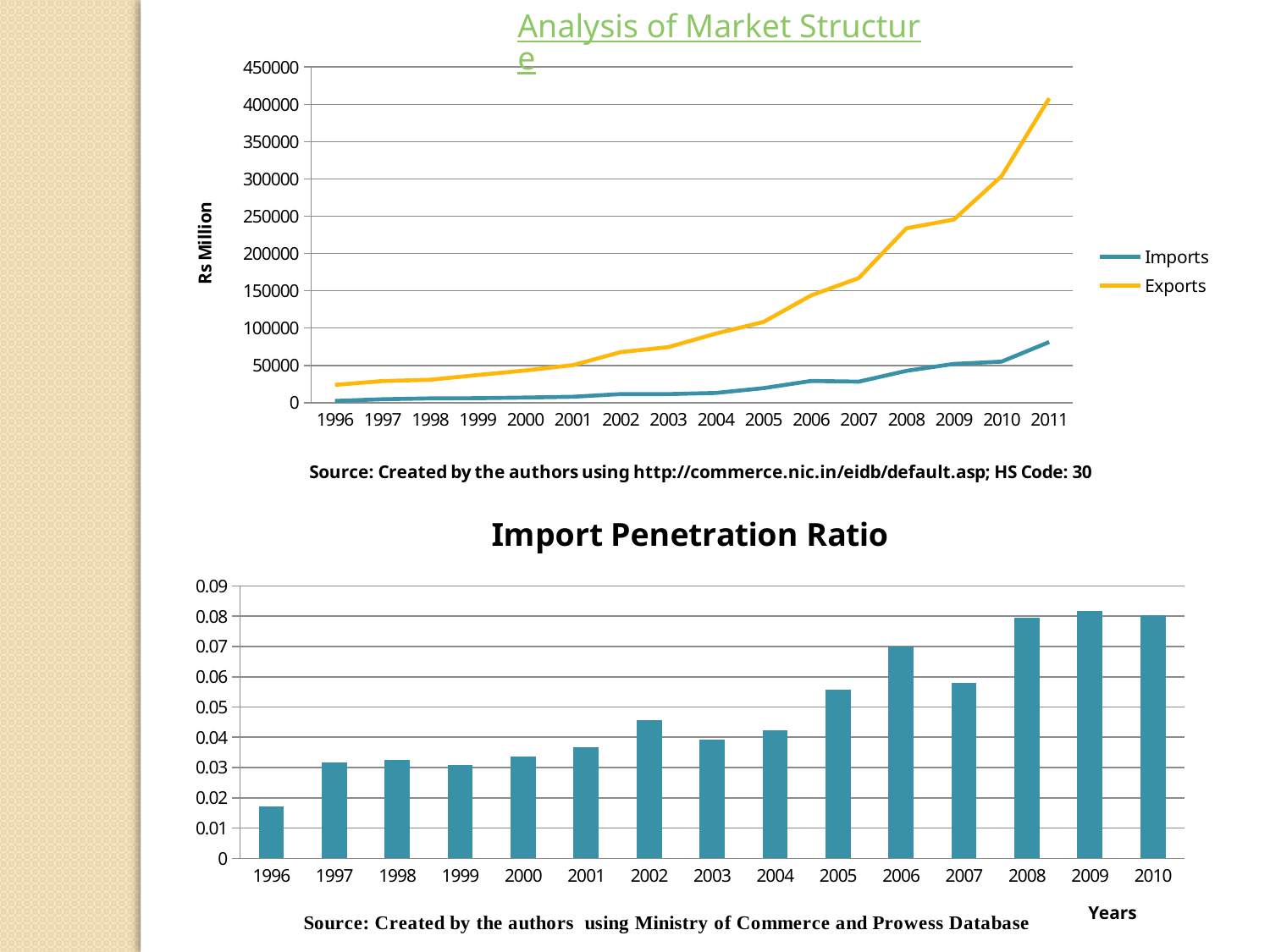
In the top chart, is the value for Exports in 2008 greater or less than 200000? greater In the 'Import Penetration Ratio' chart, is the value for 2005 greater or less than 0.05? greater In the top chart, is the value for Exports in 2011 greater or less than 350000? greater How many years are shown on the x axis of the 'Import Penetration Ratio' chart? 15 In the top chart, do Exports generally rise or fall from 1996 to 2011? rise What type of chart is the 'Import Penetration Ratio' chart? bar chart In the 'Import Penetration Ratio' chart, which year has the larger value, 2006 or 2007? 2006 What type of chart is the top chart on the slide? line chart In the top chart, which series has the higher value in 2011, Imports or Exports? Exports How many series does the legend of the top chart list? 2 In the 'Import Penetration Ratio' chart, which year has the lowest value? 1996